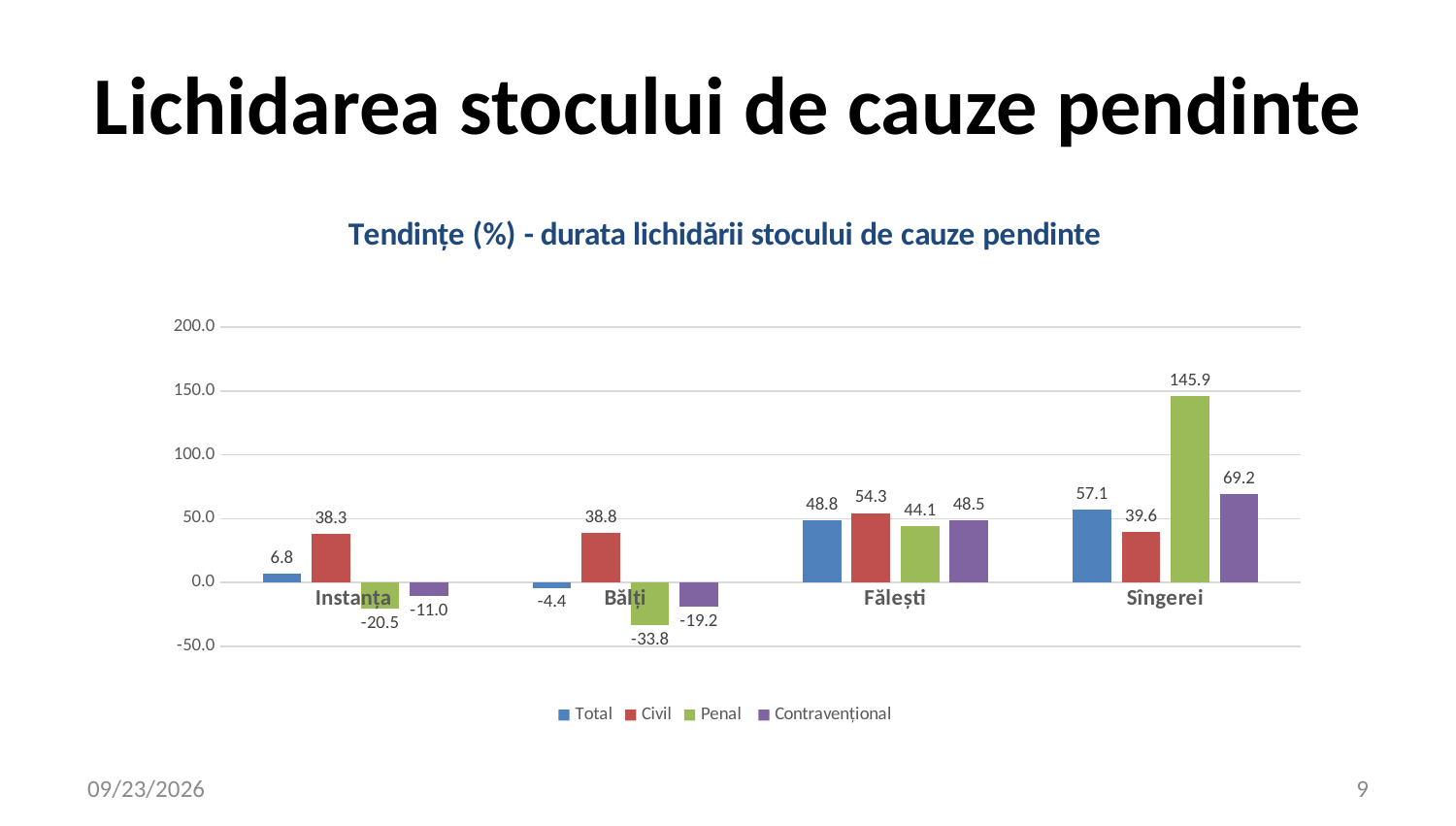
What is the Penal value for Sîngerei? 145.9 How many series does the legend list? 4 What is the title of the chart? Tendințe (%) - durata lichidării stocului de cauze pendinte How many categories are shown on the x axis? 4 What is the Civil value for Fălești? 54.3 What is the Contravențional value for Instanța? -11.0 What is the Total value for Bălți? -4.4 What kind of chart is shown on the slide? Bar chart Which category has the highest Penal value? Sîngerei What is the difference between the Contravențional values for Sîngerei and Fălești? 20.7 Which category has the lowest Penal value? Bălți Which is larger, the Total value for Sîngerei or the Total value for Fălești? Sîngerei